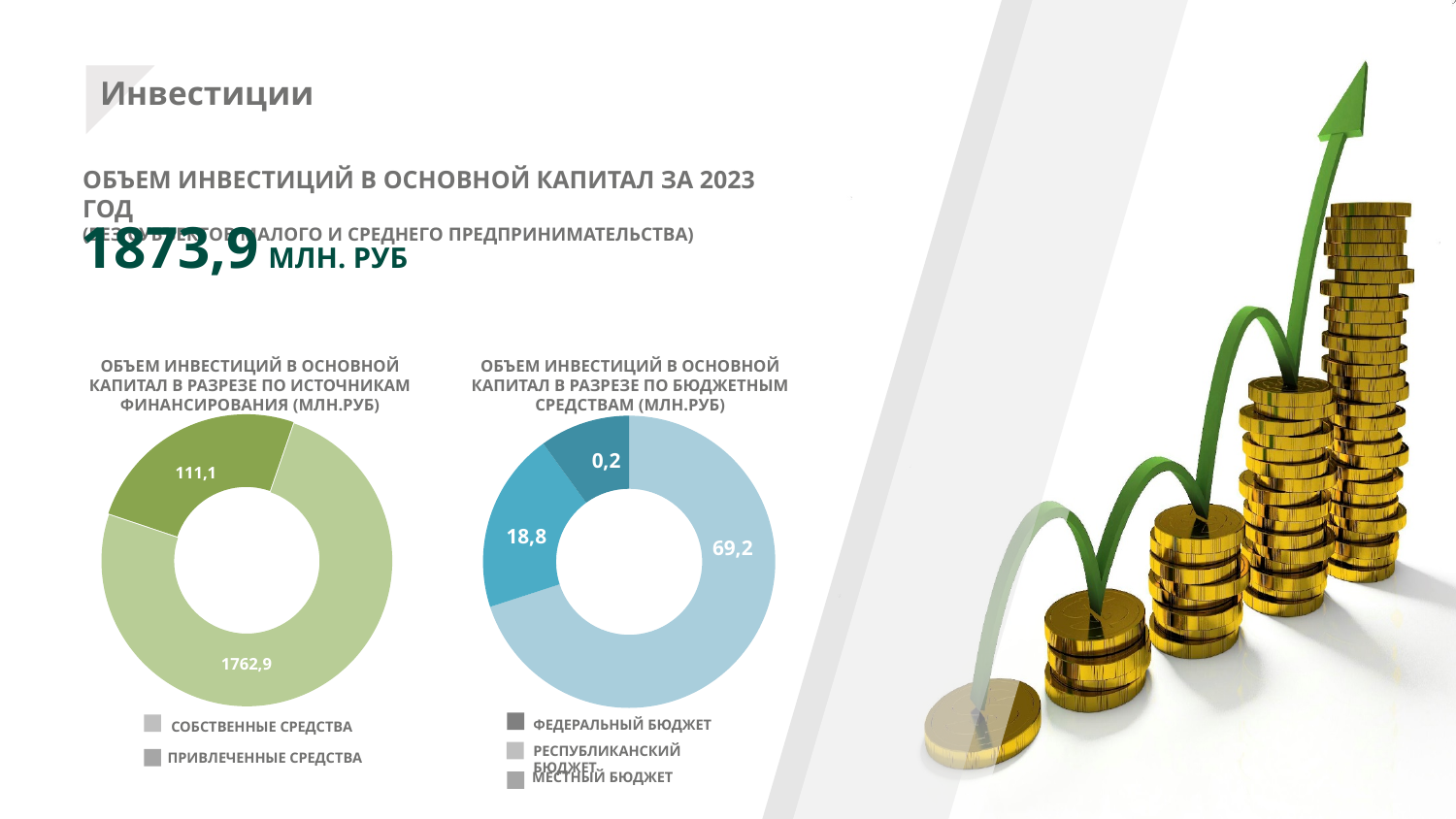
In the right chart (по бюджетным средствам), which is larger: the slice labelled 18,8 or the slice labelled 0,2? 18,8 How many entries does the legend of the right chart (по бюджетным средствам) list? 3 How many entries does the legend of the left chart (по источникам финансирования) list? 2 In the left chart (по источникам финансирования), what is the difference between the two slice values, 1762,9 and 111,1? 1651,8 In the right chart (по бюджетным средствам), what is the difference between the slices labelled 69,2 and 18,8? 50,4 How many slices does the left chart (по источникам финансирования) have? 2 In the left chart (по источникам финансирования), what is the value of the smallest slice? 111,1 What kind of chart is the left chart titled "Объем инвестиций в основной капитал в разрезе по источникам финансирования (млн.руб)"? Donut (pie) chart In the right chart (по бюджетным средствам), what is the total of all three slice values? 88,2 In the right chart (по бюджетным средствам), what is the value of the smallest slice? 0,2 In the left chart (по источникам финансирования), what is the value of the largest slice? 1762,9 In the right chart (по бюджетным средствам), what is the value of the largest slice? 69,2